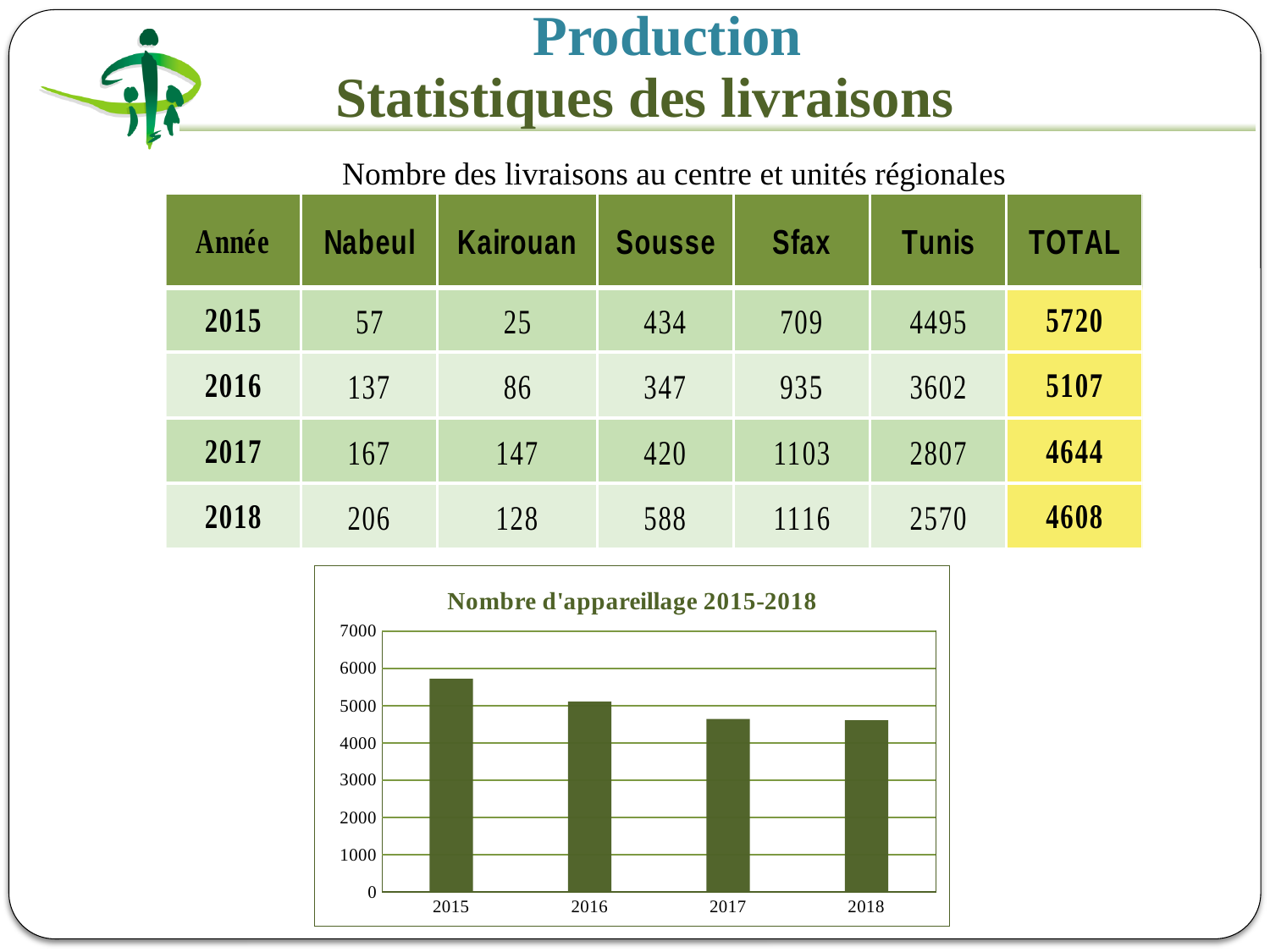
Is the value for 2018 in the chart greater or less than 5000? less What is the maximum value shown on the chart's vertical axis? 7000 Do the values in the chart rise or fall from 2015 to 2018? fall Is the value for 2015 in the chart greater or less than 5000? greater Is the value for 2017 in the chart greater or less than 4000? greater Which is larger in the chart, the value for 2016 or the value for 2018? 2016 Which year has the highest bar in the chart? 2015 What kind of chart is shown on the slide? bar chart What is the title of the chart? Nombre d'appareillage 2015-2018 How many years are plotted in the chart? 4 Which is larger in the chart, the value for 2015 or the value for 2016? 2015